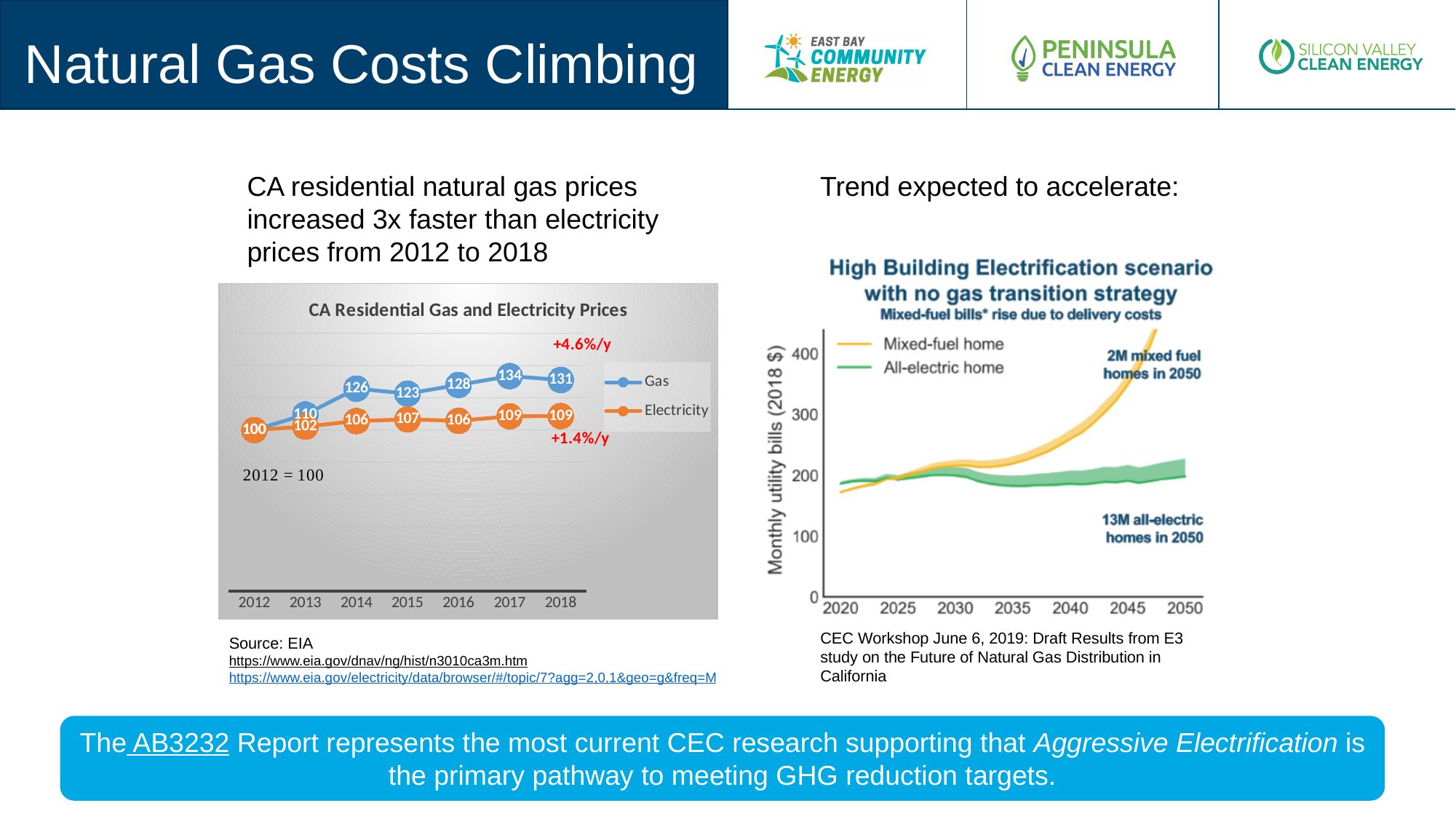
In the chart titled 'CA Residential Gas and Electricity Prices', what is the Gas value for 2014? 126 What kind of chart is the chart titled 'High Building Electrification scenario with no gas transition strategy'? line chart In the chart titled 'CA Residential Gas and Electricity Prices', what is the Electricity value for 2018? 109 In the chart titled 'CA Residential Gas and Electricity Prices', which year has the highest Gas value? 2017 In the chart titled 'CA Residential Gas and Electricity Prices', what is the difference between the Gas and Electricity values in 2018? 22 In the chart titled 'High Building Electrification scenario with no gas transition strategy', does the Mixed-fuel home line rise or fall from 2030 to 2050? rise In the chart titled 'CA Residential Gas and Electricity Prices', how many series does the legend list? 2 In the chart titled 'CA Residential Gas and Electricity Prices', which series has the larger value in 2016, Gas or Electricity? Gas In the chart titled 'CA Residential Gas and Electricity Prices', how many years are shown on the x axis? 7 In the chart titled 'CA Residential Gas and Electricity Prices', what is the Gas value for 2017? 134 In the chart titled 'CA Residential Gas and Electricity Prices', what annual growth rate is annotated for Gas? +4.6%/y In the chart titled 'High Building Electrification scenario with no gas transition strategy', is the Mixed-fuel home value in 2040 greater or less than 200? greater